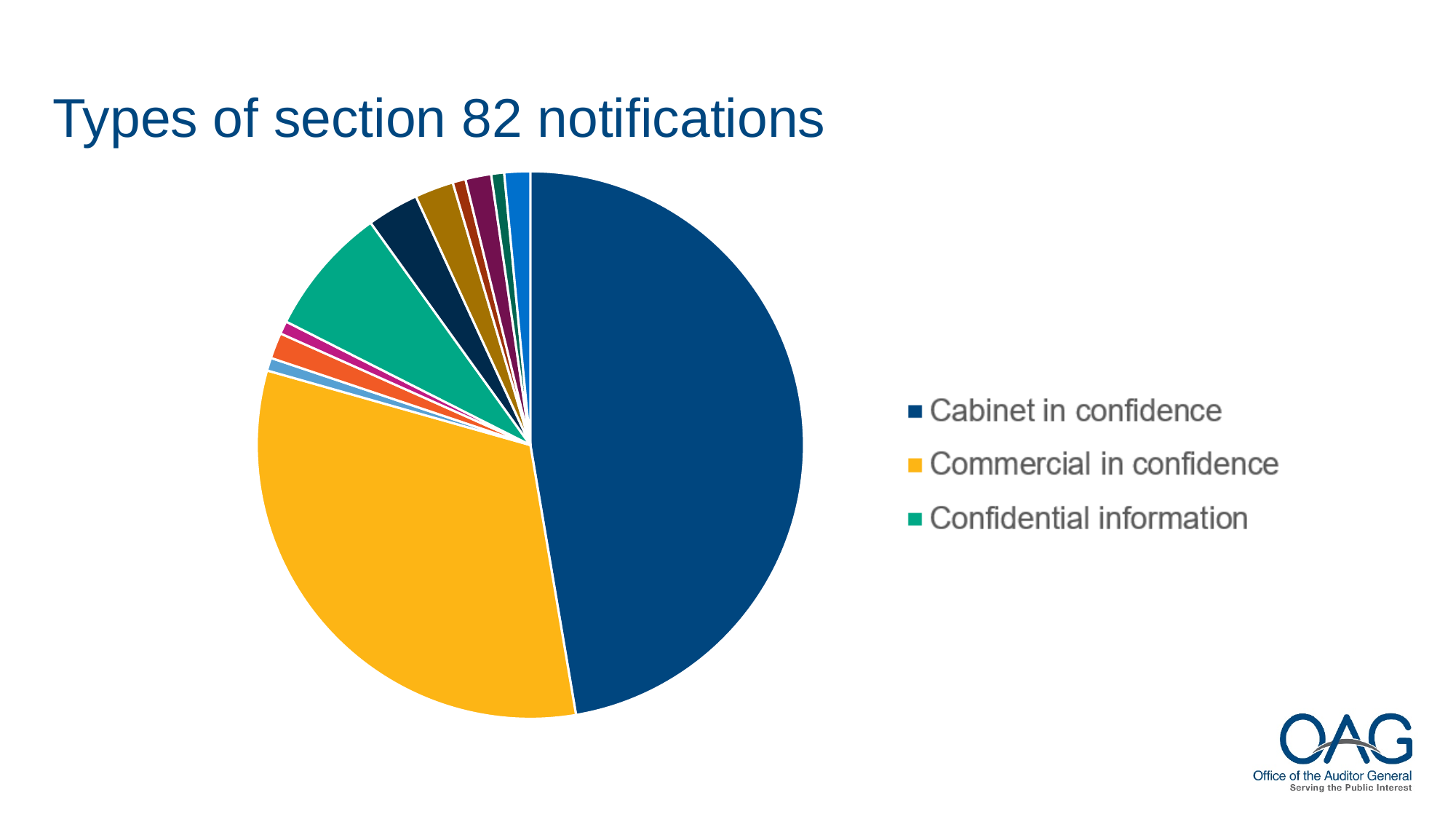
How many entries does the chart's legend list? 3 Which slice is larger: Commercial in confidence or Confidential information? Commercial in confidence What is the title of the chart on the slide? Types of section 82 notifications Which slice is larger: Cabinet in confidence or Confidential information? Cabinet in confidence What colour is the Commercial in confidence slice in the legend? Yellow What kind of chart is shown on the slide? Pie chart Does the Cabinet in confidence slice take up more or less than half of the pie? Less Which slice is larger: Cabinet in confidence or Commercial in confidence? Cabinet in confidence Of the three categories named in the legend, which has the smallest slice? Confidential information Which category has the largest slice of the pie? Cabinet in confidence